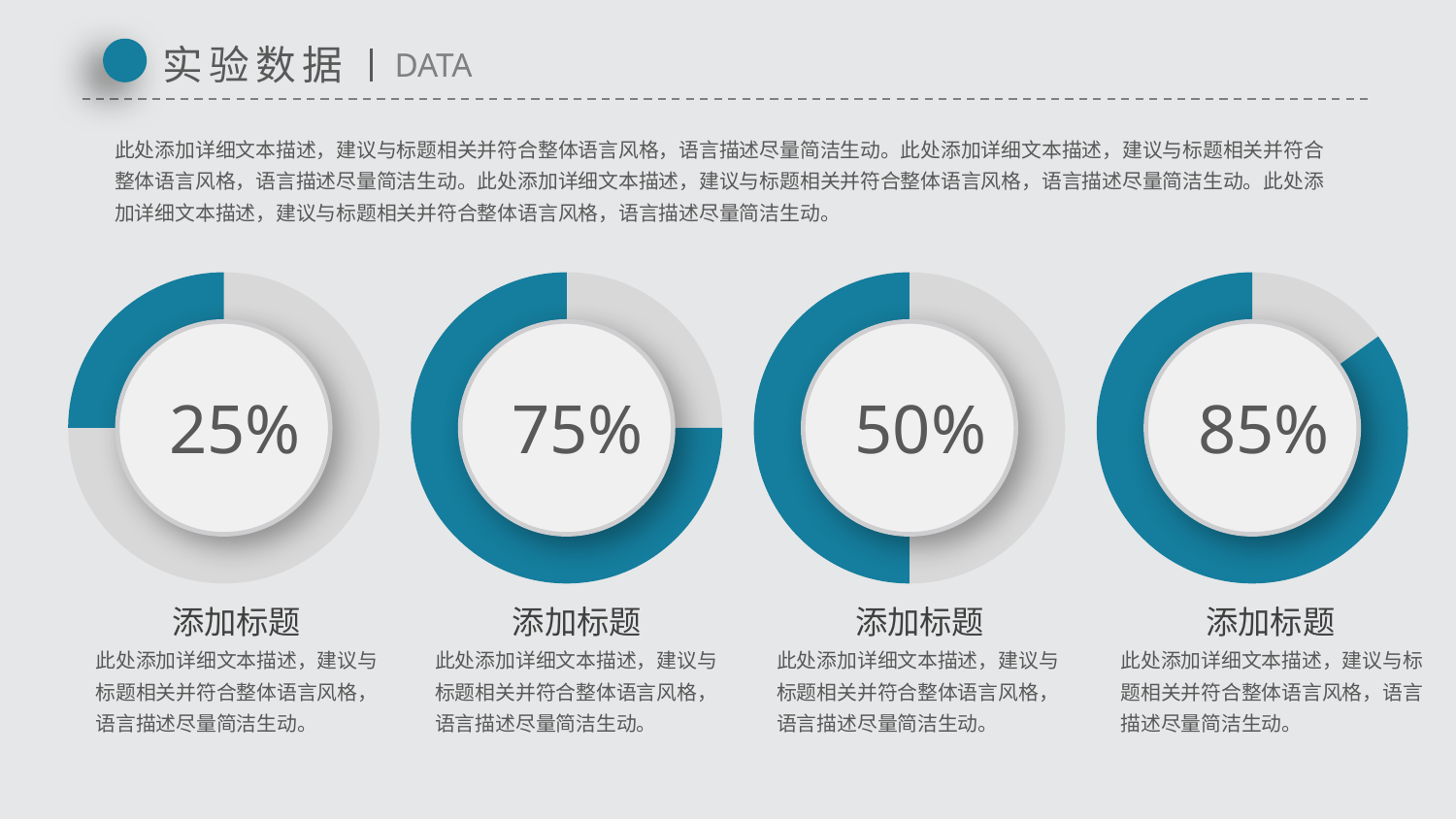
Which is larger, the percentage in the second ring chart or the third ring chart? The second ring chart (75%) What percentage is shown in the leftmost ring chart? 25% Which ring chart shows the highest percentage? The rightmost one (85%) What percentage is shown in the third ring chart from the left? 50% What is the difference between the percentage in the second ring chart and the third ring chart? 25% Which ring chart shows the lowest percentage? The leftmost one (25%) What is the difference between the percentage in the rightmost ring chart and the leftmost ring chart? 60% How many ring charts are shown on the slide? 4 What colour is used for the filled portion of each ring chart? Teal blue What percentage is shown in the rightmost ring chart? 85% What percentage is shown in the second ring chart from the left? 75% What kind of chart is used to display the percentages on the slide? Ring (donut) chart